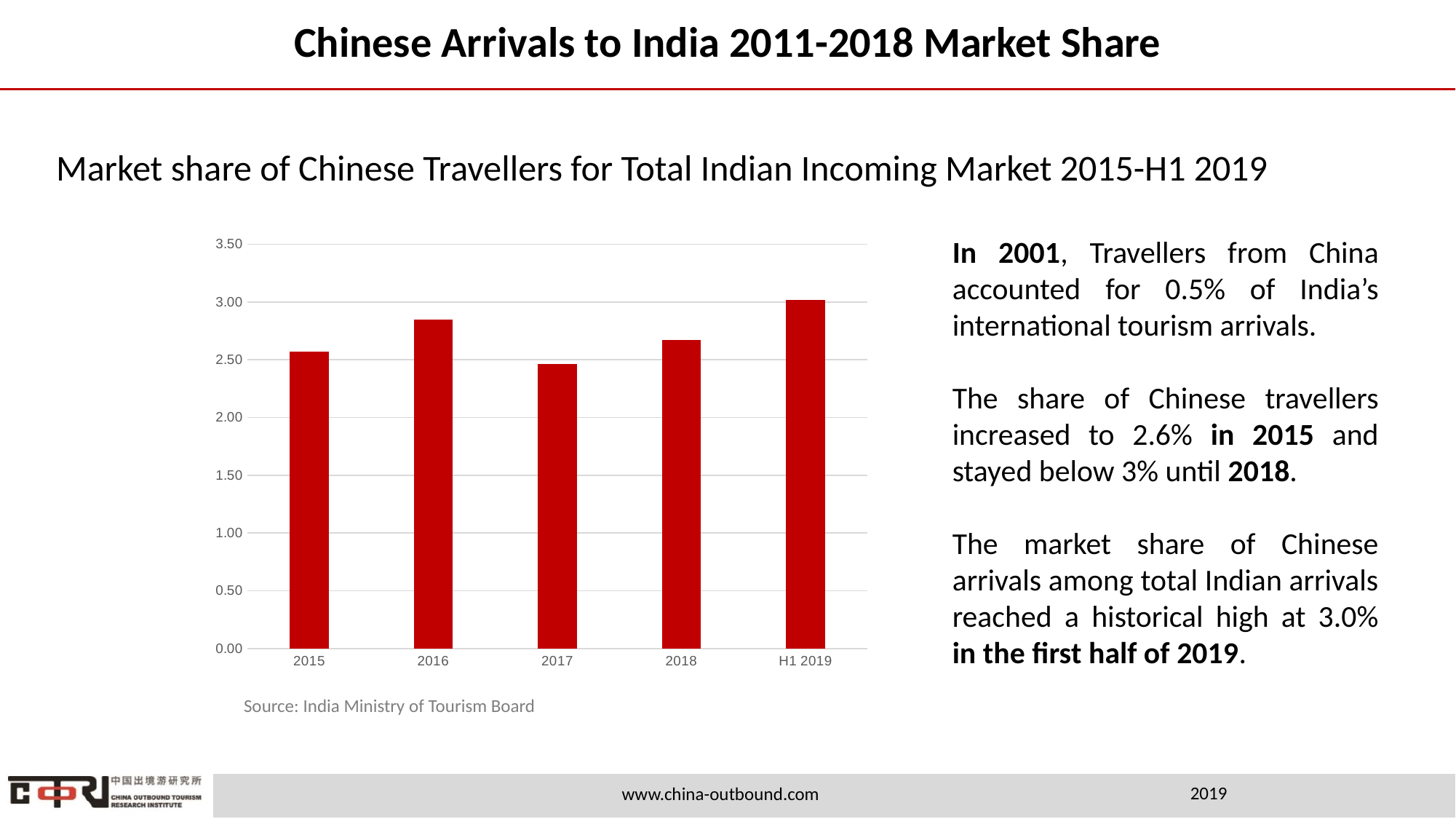
Is the value for 2016 greater or less than 3.00? less Which period has the highest market share in the chart? H1 2019 Did the market share rise or fall from 2016 to 2017? fall What source is cited below the chart? India Ministry of Tourism Board Is the value for 2018 greater or less than 2.50? greater Which is larger, the value for 2016 or the value for 2017? 2016 How many bars (periods) are plotted in the chart? 5 What kind of chart is shown on the slide? bar chart Which period has the lowest market share in the chart? 2017 Is the value for 2017 greater or less than 2.00? greater